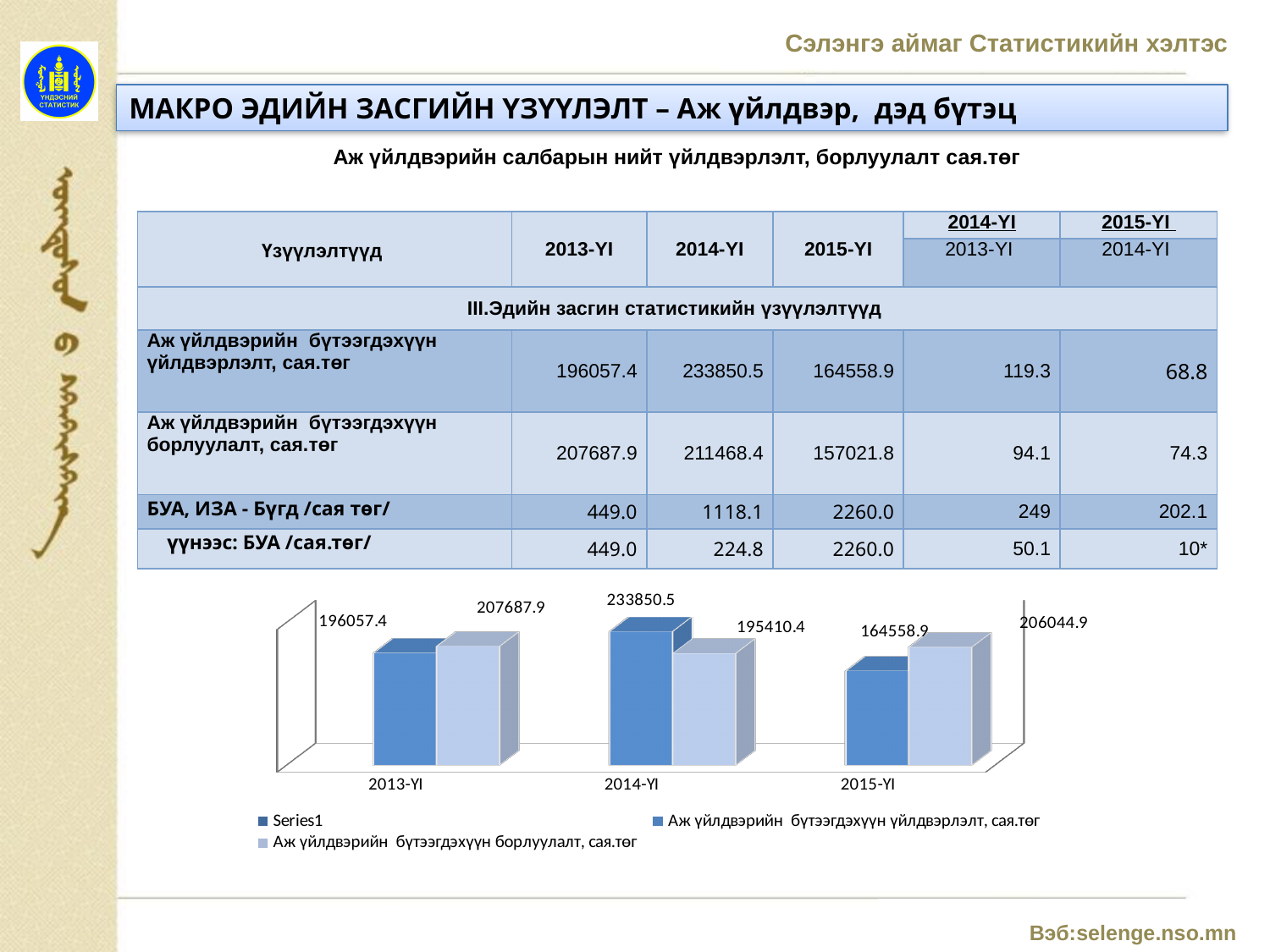
In which year is Аж үйлдвэрийн бүтээгдэхүүн үйлдвэрлэлт, сая.төг lowest in the chart? 2015-YI For 2015-YI, which is larger in the chart: Аж үйлдвэрийн бүтээгдэхүүн үйлдвэрлэлт or Аж үйлдвэрийн бүтээгдэхүүн борлуулалт? Аж үйлдвэрийн бүтээгдэхүүн борлуулалт, сая.төг How many categories are shown on the x axis of the chart? 3 What type of chart is shown on the slide? bar chart What is the value of Аж үйлдвэрийн бүтээгдэхүүн борлуулалт, сая.төг for 2015-YI in the chart? 206044.9 How many series does the chart legend list? 3 What is the first entry listed in the chart legend? Series1 Does Аж үйлдвэрийн бүтээгдэхүүн үйлдвэрлэлт, сая.төг rise or fall from 2014-YI to 2015-YI in the chart? fall What is the value of Аж үйлдвэрийн бүтээгдэхүүн борлуулалт, сая.төг for 2014-YI in the chart? 195410.4 In which year is Аж үйлдвэрийн бүтээгдэхүүн үйлдвэрлэлт, сая.төг highest in the chart? 2014-YI What is the difference between the two labelled bars for 2014-YI in the chart? 38440.1 What is the value of Аж үйлдвэрийн бүтээгдэхүүн үйлдвэрлэлт, сая.төг for 2013-YI in the chart? 196057.4